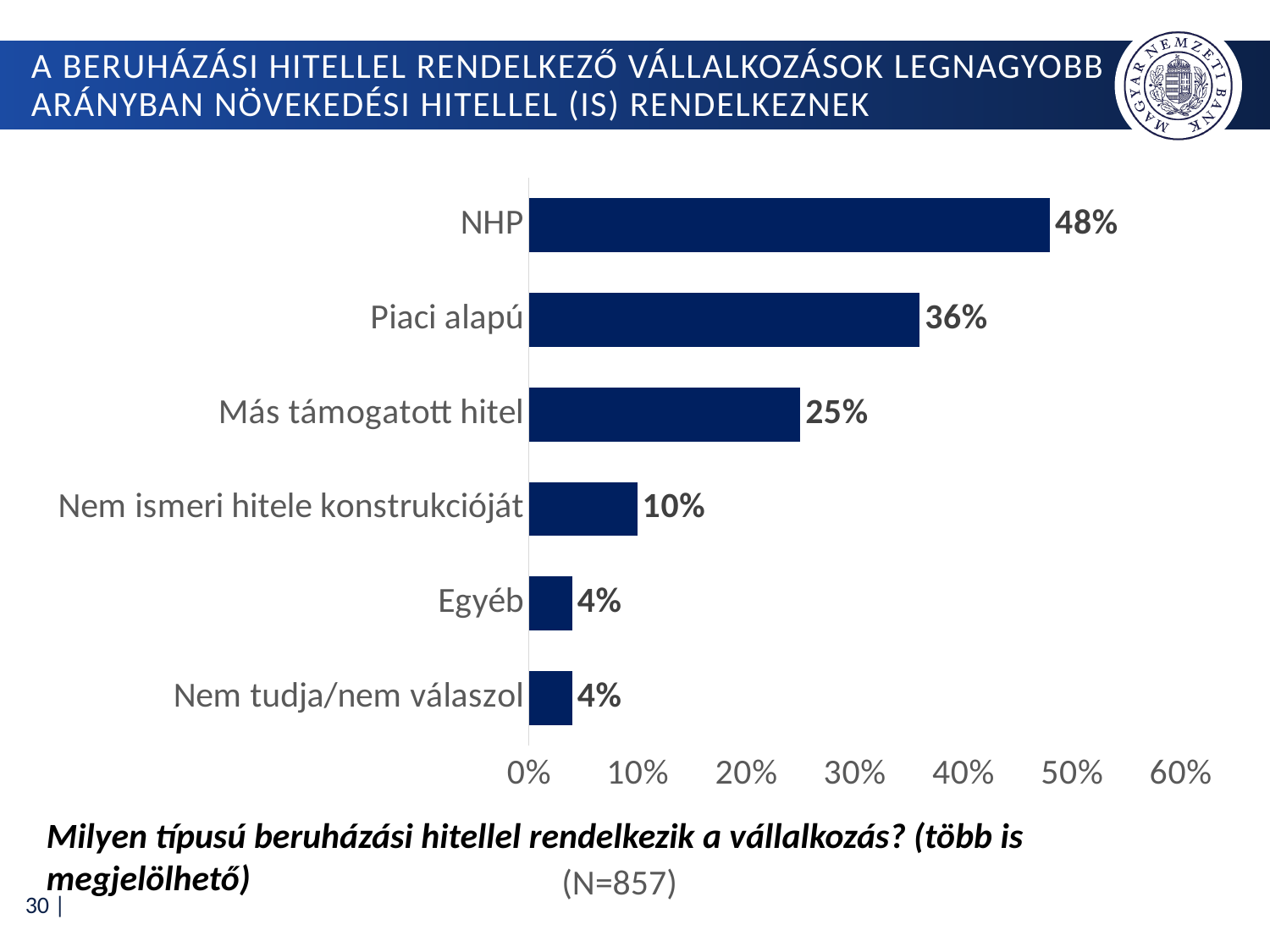
Which is larger, the value for Más támogatott hitel or the value for Nem ismeri hitele konstrukcióját? Más támogatott hitel Is the value for NHP greater or less than 40%? greater What is the difference between the values for Piaci alapú and Más támogatott hitel? 11% What kind of chart is shown on the slide? bar chart What is the value for Piaci alapú? 36% What is the sample size (N) stated below the chart? N=857 How many categories are shown in the chart? 6 What is the difference between the values for NHP and Piaci alapú? 12% What is the value for Nem ismeri hitele konstrukcióját? 10% What is the value for NHP? 48% What is the value for Más támogatott hitel? 25% Which category has the highest value? NHP